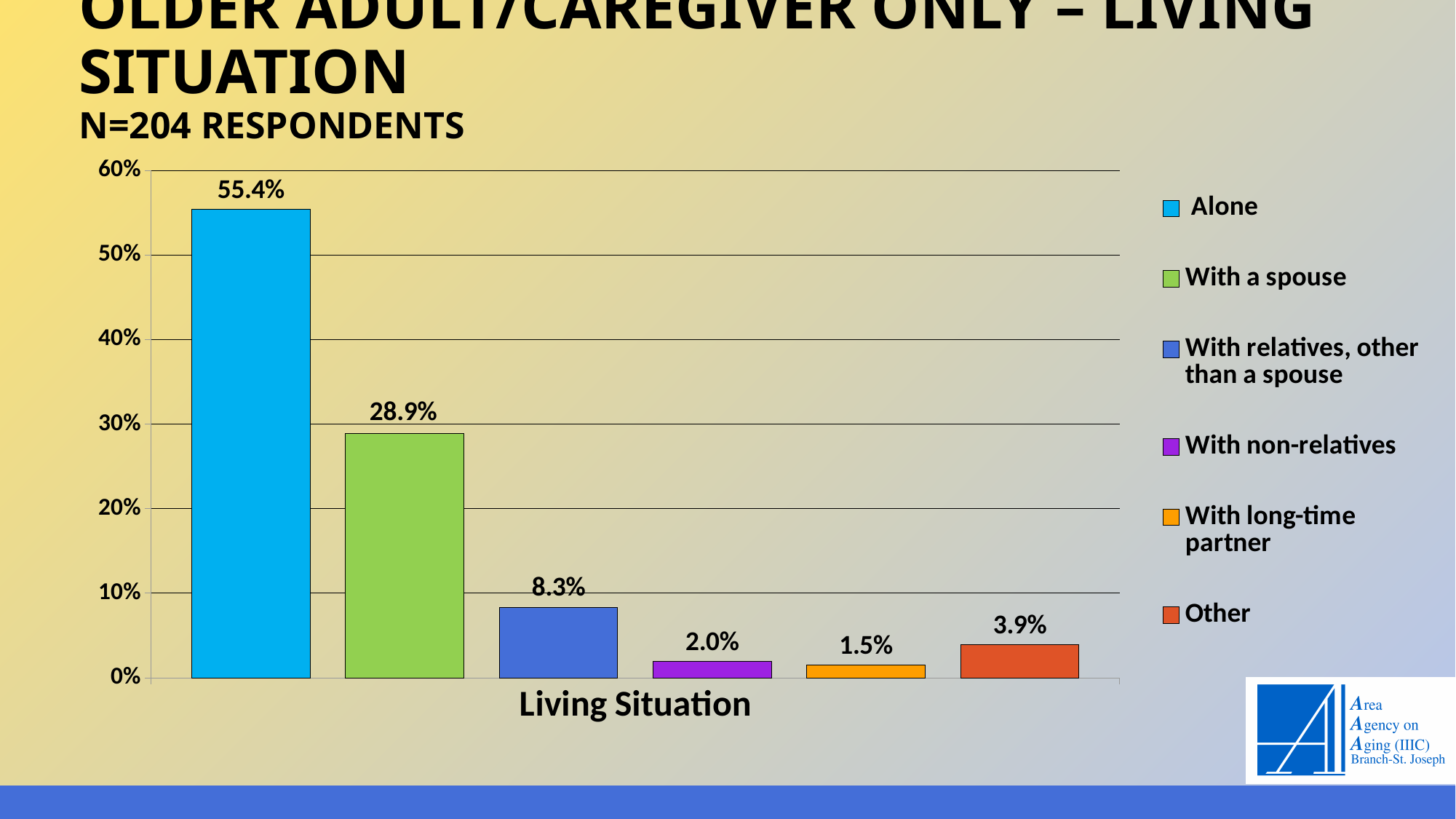
What kind of chart is shown on the slide? Bar chart What is the value for 'With long-time partner'? 1.5% What percentage of respondents live alone? 55.4% Which living situation has the highest percentage? Alone How many respondents does the slide say took part? 204 Is the value for 'Alone' greater or less than 50%? greater Which is larger, 'Other' or 'With non-relatives'? Other Which living situation has the lowest percentage? With long-time partner What is the value for 'With relatives, other than a spouse'? 8.3% What percentage of respondents live with a spouse? 28.9% How many living situation categories are shown in the chart? 6 What is the difference between the 'Alone' and 'With a spouse' percentages? 26.5%